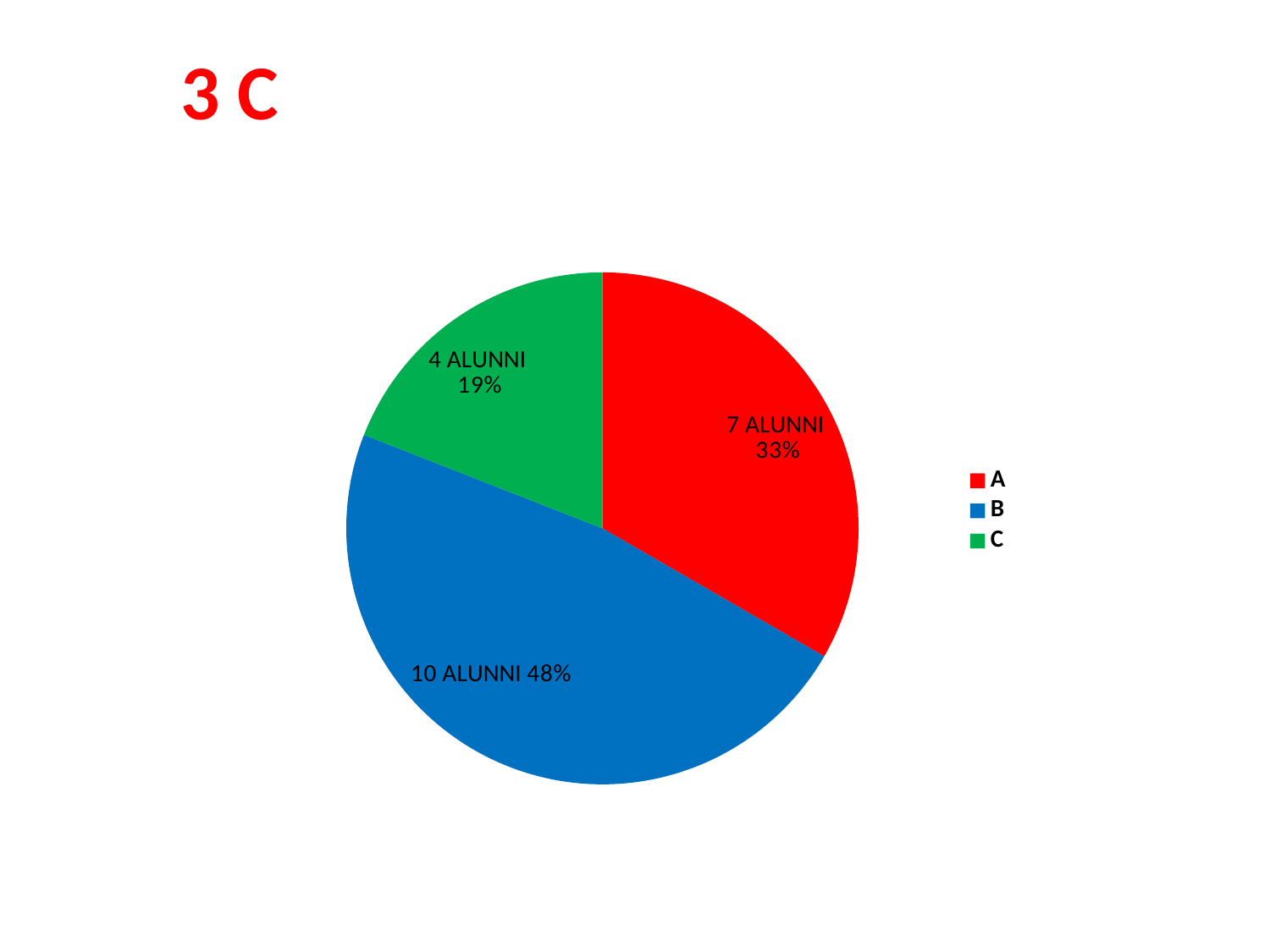
Which colour represents category A in the legend? red Which category has the smallest slice? C How many alunni are in category C? 4 ALUNNI How many slices does the pie chart have? 3 How many entries does the legend list? 3 Which category has the largest slice? B What percentage share does slice C have? 19% How many alunni are in category B? 10 ALUNNI What percentage share does slice A have? 33% What is the difference in alunni between category A and category C? 3 What percentage share does slice B have? 48% What kind of chart is shown on the slide? pie chart